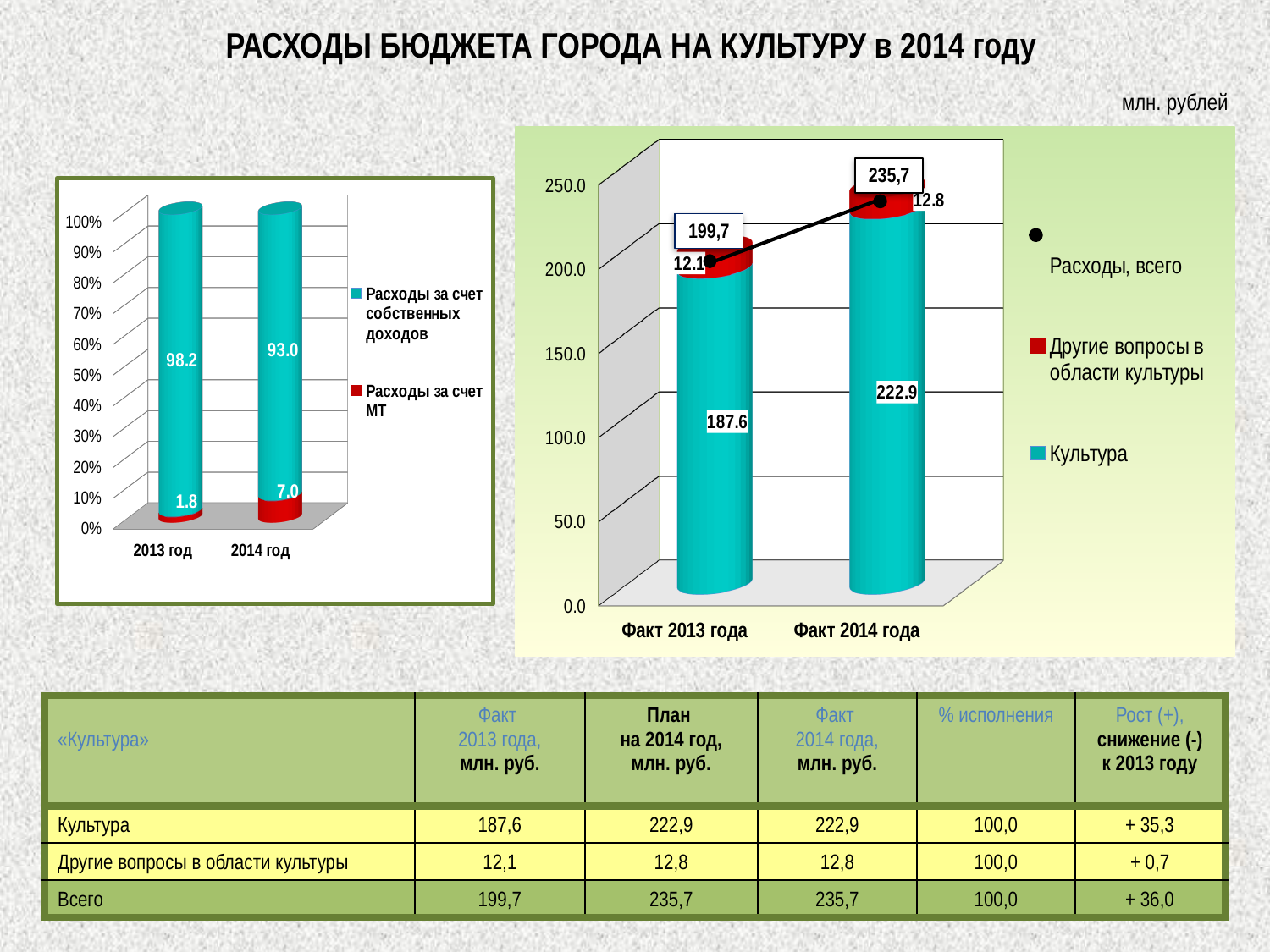
In the right chart, what is the difference between the 'Культура' values for Факт 2014 года and Факт 2013 года? 35.3 In the left chart, what is the value of 'Расходы за счет МТ' for 2014 год? 7.0 What kind of chart is the right chart? bar chart In the left chart, which year has the larger value for 'Расходы за счет МТ', 2013 год or 2014 год? 2014 год In the left chart, what is the difference between the 'Расходы за счет собственных доходов' values for 2013 год and 2014 год? 5.2 In the right chart, what is the value of 'Другие вопросы в области культуры' for Факт 2013 года? 12.1 In the left chart, what is the value of 'Расходы за счет собственных доходов' for 2013 год? 98.2 In the right chart, what is the value of 'Культура' for Факт 2014 года? 222.9 In the left chart, how many series does the legend list? 2 In the right chart, what is the 'Расходы, всего' value for Факт 2014 года? 235,7 In the right chart, does the 'Расходы, всего' line rise or fall from Факт 2013 года to Факт 2014 года? rise In the right chart, how many categories are shown on the x axis? 2